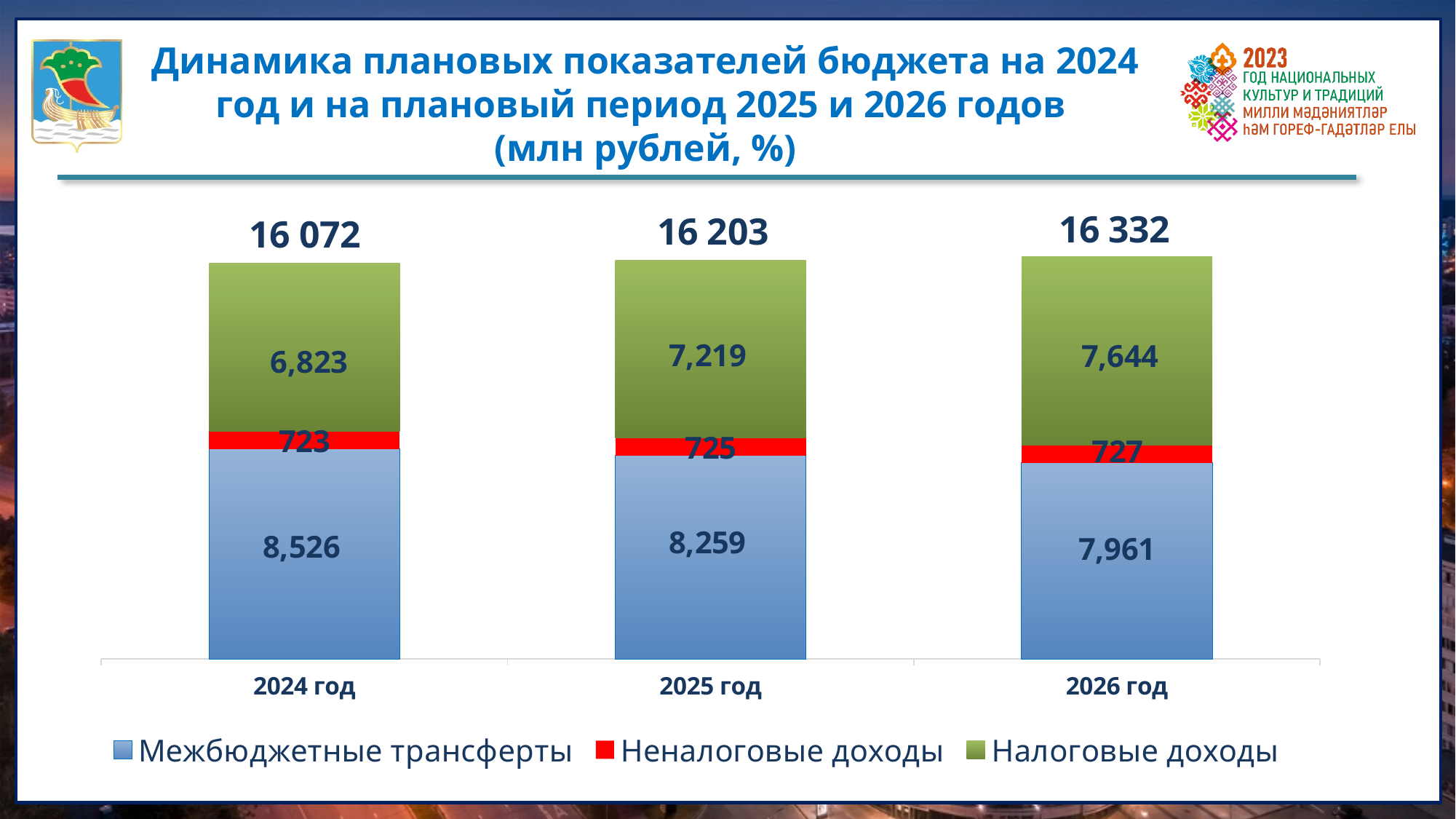
What is the difference between Налоговые доходы in 2026 год and in 2024 год? 821 Which is larger: Межбюджетные трансферты in 2024 год or Налоговые доходы in 2024 год? Межбюджетные трансферты in 2024 год How many series does the legend list? 3 Which year has the lowest value for Межбюджетные трансферты? 2026 год How many years (categories) are shown on the x axis? 3 What is the value of Межбюджетные трансферты for 2024 год? 8,526 What is the value of Неналоговые доходы for 2025 год? 725 Which year has the highest value for Налоговые доходы? 2026 год Do the bar totals rise or fall from 2024 год to 2026 год? Rise What is the value of Налоговые доходы for 2026 год? 7,644 What is the total shown above the stacked bar for 2025 год? 16 203 What kind of chart is shown on the slide? Stacked bar chart